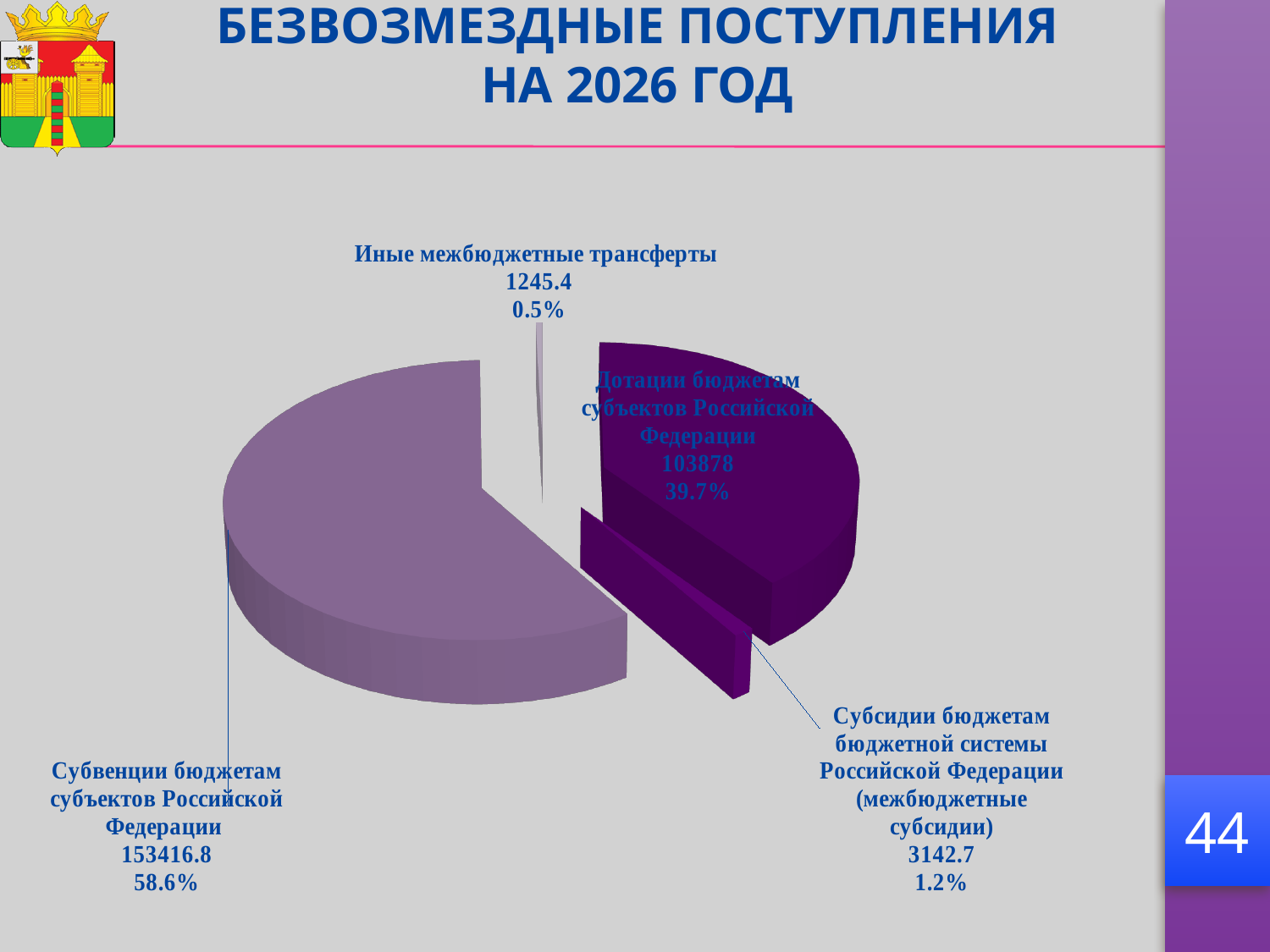
What is the value for Субвенции бюджетам субъектов Российской Федерации? 153416.8 How many slices does the pie chart have? 4 Which category has the largest share of the pie? Субвенции бюджетам субъектов Российской Федерации Which category has the smallest share of the pie? Иные межбюджетные трансферты What is the title of the slide containing the chart? БЕЗВОЗМЕЗДНЫЕ ПОСТУПЛЕНИЯ НА 2026 ГОД What is the value for Дотации бюджетам субъектов Российской Федерации? 103878 What is the difference between the values for Субвенции бюджетам субъектов Российской Федерации and Дотации бюджетам субъектов Российской Федерации? 49538.8 Which is larger: the value for Субсидии бюджетам бюджетной системы Российской Федерации (межбюджетные субсидии) or Иные межбюджетные трансферты? Субсидии бюджетам бюджетной системы Российской Федерации (межбюджетные субсидии) What is the value for Иные межбюджетные трансферты? 1245.4 What share of the pie does Дотации бюджетам субъектов Российской Федерации represent? 39.7% What type of chart is shown on the slide? Pie chart What share of the pie does Субсидии бюджетам бюджетной системы Российской Федерации (межбюджетные субсидии) represent? 1.2%